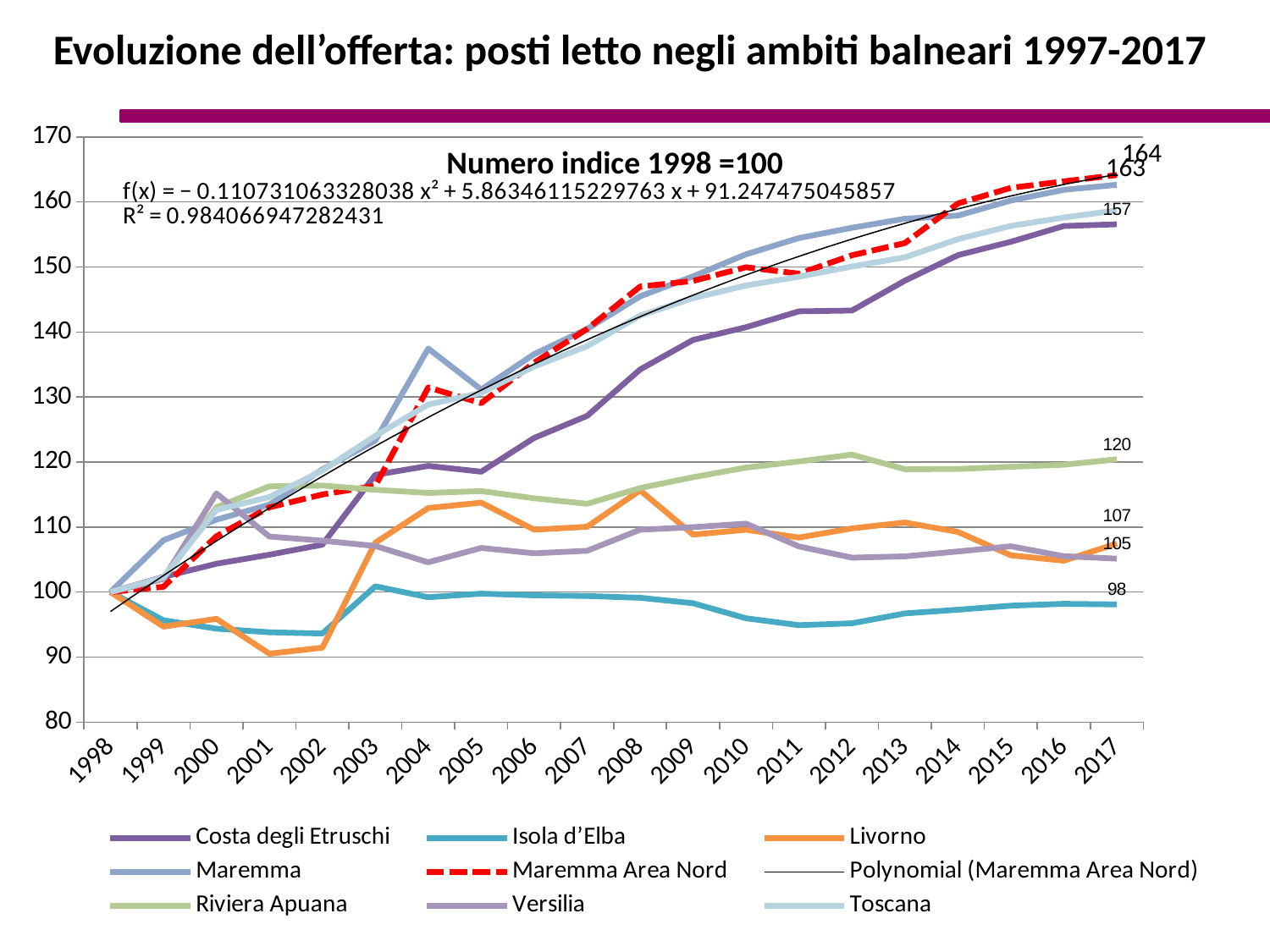
Which series has the highest value in 2017? Maremma Area Nord How many years are plotted along the x axis? 20 Which series has the lowest value in 2017? Isola d'Elba What is the value for Maremma Area Nord in 2017? 164 What is the difference between the 2017 values of Maremma Area Nord and Isola d'Elba? 66 What is the value for Riviera Apuana in 2017? 120 Does the Maremma series rise or fall overall from 1998 to 2017? rise What type of chart is shown on the slide? line chart How many series does the legend list? 9 What is the value for Isola d'Elba in 2017? 98 Is the value for Livorno in 2001 greater or less than 100? less In 2017, which is larger: Riviera Apuana or Livorno? Riviera Apuana